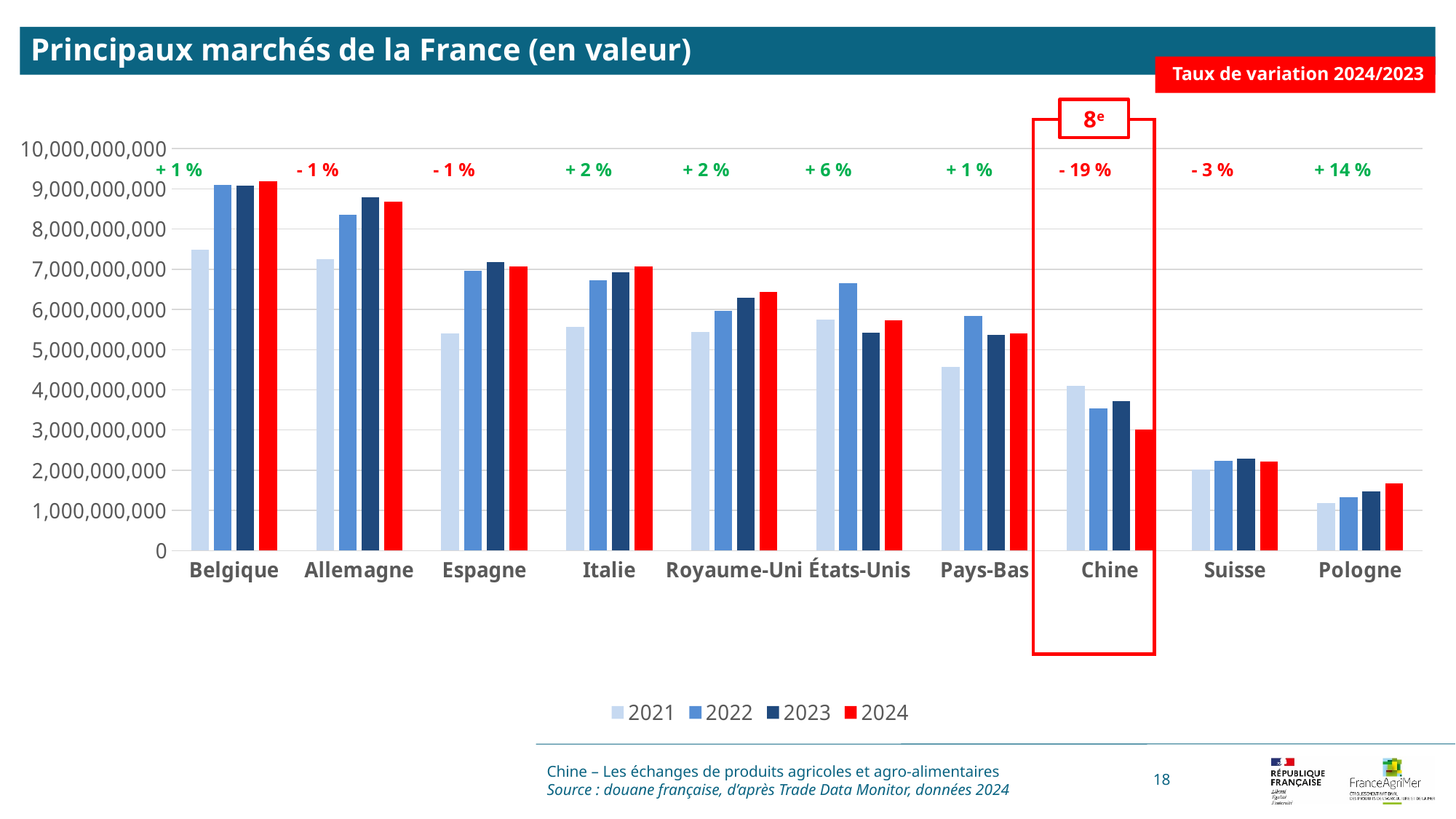
Is the 2024 value for Allemagne greater or less than 9,000,000,000? less What is the 2024/2023 variation rate shown for Pologne? + 14 % How many countries are shown on the x axis of the chart? 10 What is the 2024/2023 variation rate shown for États-Unis? + 6 % Which is larger for États-Unis: the 2022 value or the 2024 value? 2022 Is the 2024 value for Chine greater or less than 4,000,000,000? less How many series does the legend list? 4 Which country has the highest 2024 value? Belgique What kind of chart is shown on the slide? bar chart Which country is highlighted with a red box and the label "8e"? Chine What is the 2024/2023 variation rate shown for Chine? - 19 % Which country has the lowest 2024 value? Pologne